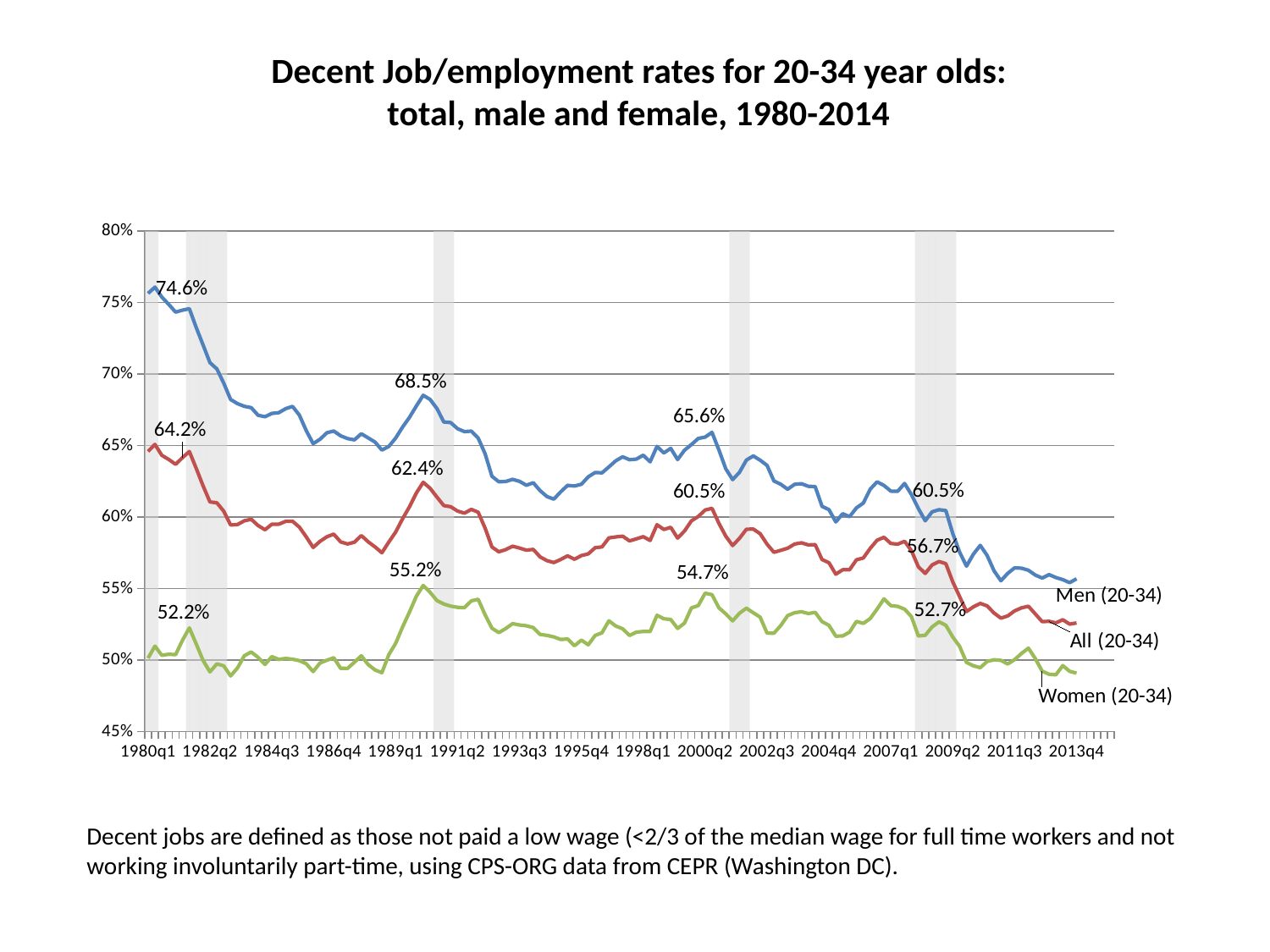
How many series are plotted on the chart? 3 What is the difference between the labelled 1980 values for Men (20-34) (74.6%) and All (20-34) (64.2%)? 10.4 percentage points What is the difference between the labelled peaks around 1990 for Men (20-34) (68.5%) and All (20-34) (62.4%)? 6.1 percentage points What is the labelled peak value for Women (20-34) around 1989-1990? 55.2% Is the value for Women (20-34) at the end of the series (2013q4) greater or less than 50%? less Which series has the higher value in 1980, Men (20-34) or Women (20-34)? Men (20-34) Is the value for Men (20-34) at the end of the series (2013q4) greater or less than 55%? greater What kind of chart is shown on the slide? line chart What is the labelled value for All (20-34) around 2008, just before the last shaded recession band? 56.7% Does the Men (20-34) line rise or fall overall from 1980 to 2014? fall What is the labelled value for All (20-34) at the start of the series in 1980? 64.2% What is the labelled value for Men (20-34) at the start of the series in 1980? 74.6%